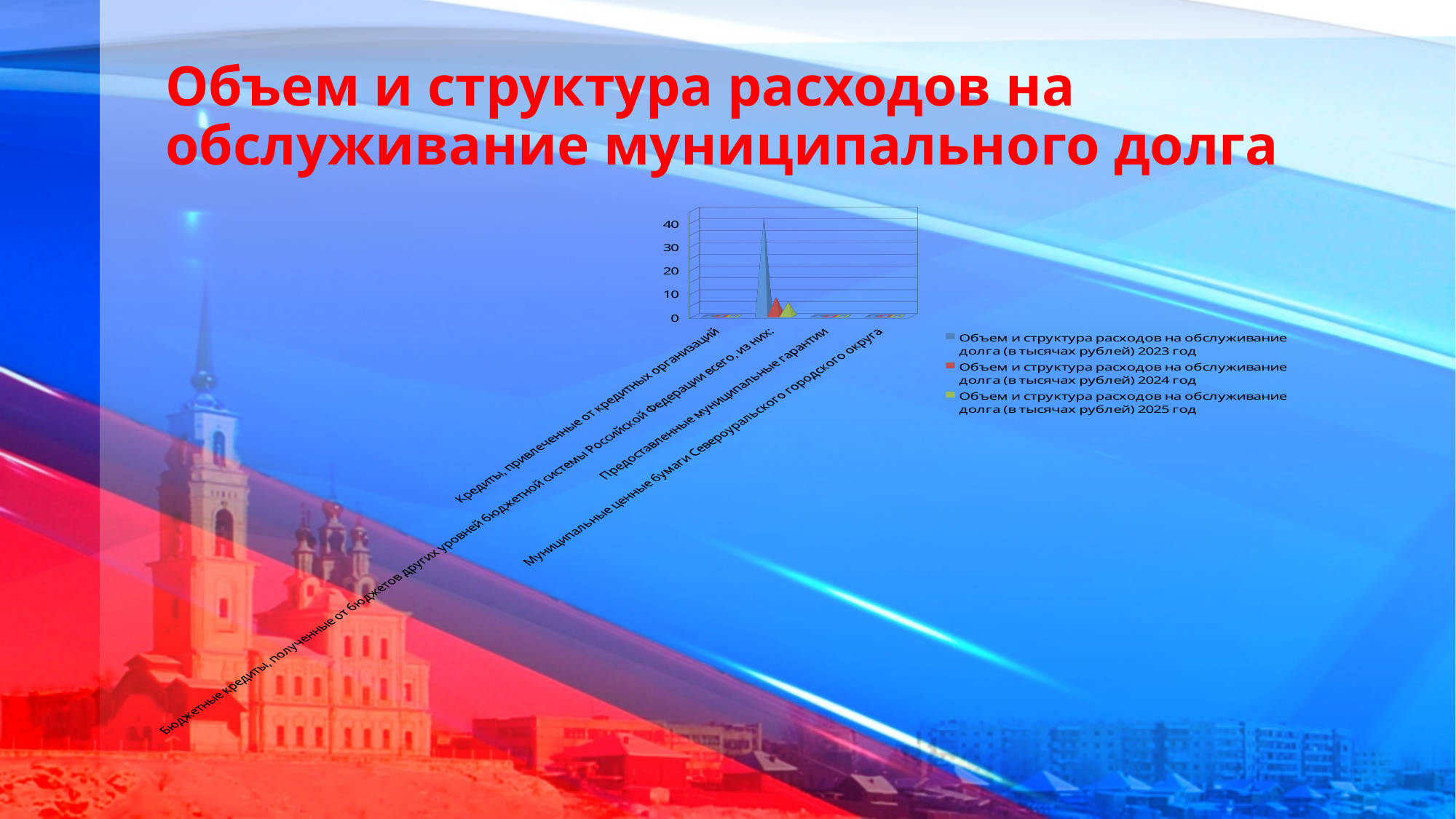
What is the highest tick value shown on the chart's vertical axis? 40 Which category has the highest value for the 2023 series? Бюджетные кредиты, полученные от бюджетов других уровней бюджетной системы Российской Федерации всего, из них: How many categories are shown on the chart's x axis? 4 What is the title of the slide containing the chart? Объем и структура расходов на обслуживание муниципального долга Is the 2025 value for "Кредиты, привлеченные от кредитных организаций" greater or less than 10? less Is the 2023 value for "Кредиты, привлеченные от кредитных организаций" greater or less than 30? less How many series does the chart legend list? 3 Is the 2024 value for "Кредиты, привлеченные от кредитных организаций" greater or less than 10? less What kind of chart is shown on the slide? bar chart